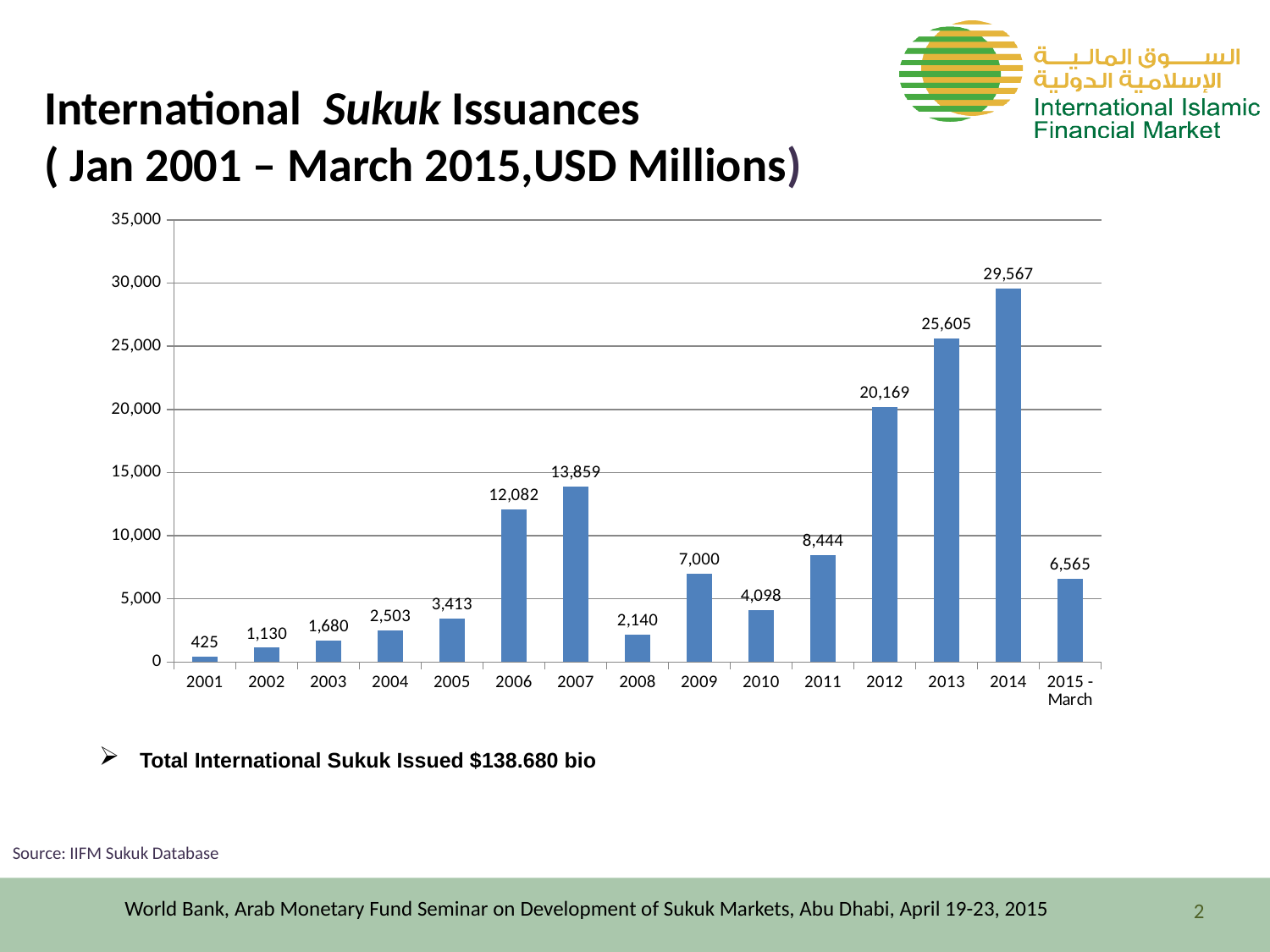
What is the difference between the issuances in 2014 and 2013? 3,962 Did international Sukuk issuances rise or fall from 2012 to 2014? Rise Is the value for 2012 greater or less than 20,000? greater What is the difference between the issuances in 2007 and 2006? 1,777 Which year had the highest international Sukuk issuances? 2014 What was the value of international Sukuk issuances in 2014? 29,567 What kind of chart is shown on the slide? Bar chart What was the value of international Sukuk issuances in 2015 - March? 6,565 How many categories are shown on the x axis of the chart? 15 Which year had larger issuances, 2009 or 2011? 2011 What was the value of international Sukuk issuances in 2008? 2,140 Which year had the lowest international Sukuk issuances? 2001